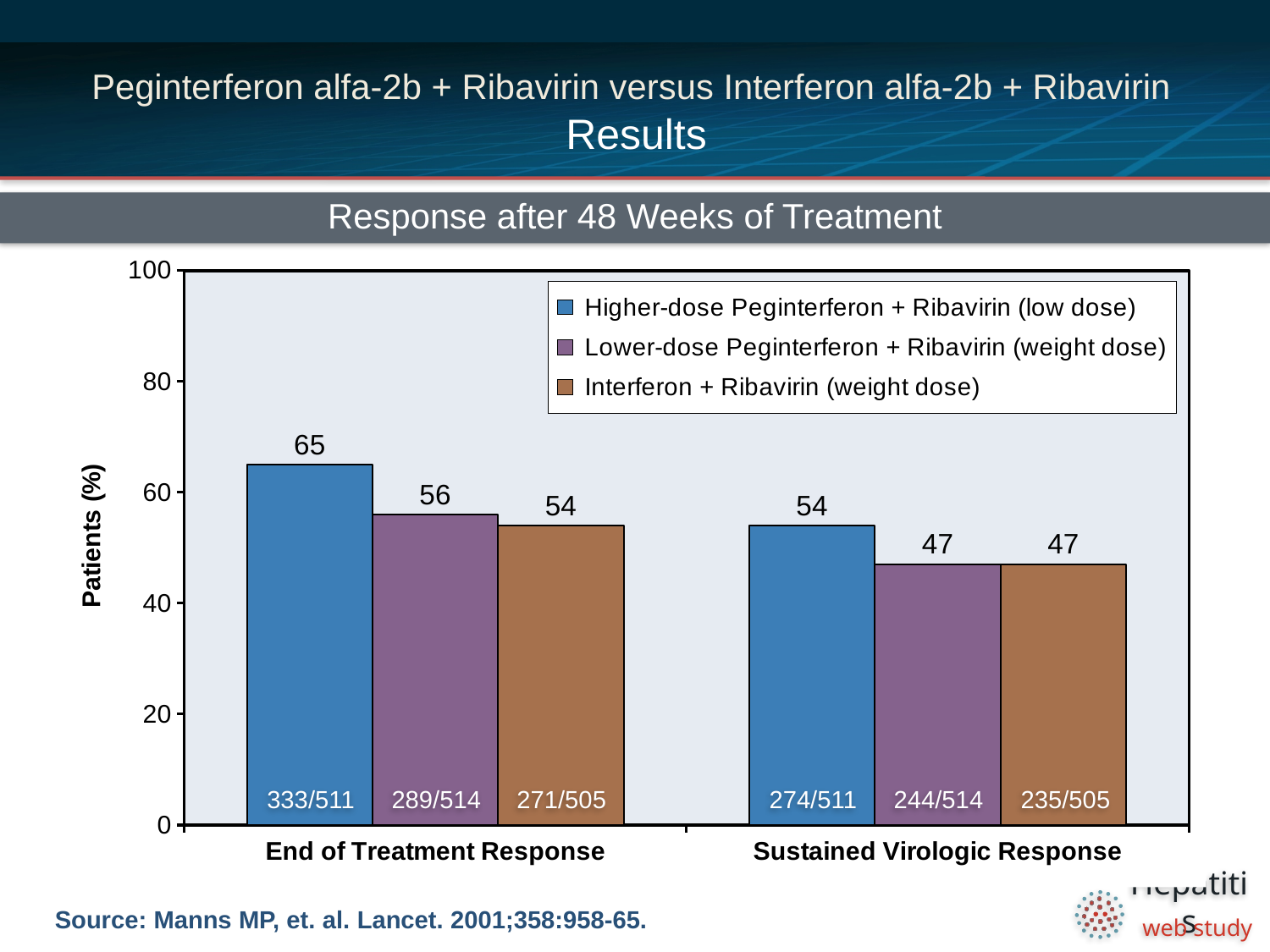
What is the Sustained Virologic Response value for Interferon + Ribavirin (weight dose)? 47 What is the difference in End of Treatment Response between Higher-dose Peginterferon + Ribavirin (low dose) and Lower-dose Peginterferon + Ribavirin (weight dose)? 9 What is the End of Treatment Response value for Higher-dose Peginterferon + Ribavirin (low dose)? 65 Which series has the highest End of Treatment Response? Higher-dose Peginterferon + Ribavirin (low dose) Which series has the lowest End of Treatment Response? Interferon + Ribavirin (weight dose) What is the difference between the End of Treatment Response and the Sustained Virologic Response for Higher-dose Peginterferon + Ribavirin (low dose)? 11 What is the Sustained Virologic Response value for Lower-dose Peginterferon + Ribavirin (weight dose)? 47 How many series does the legend list? 3 Which is larger: the End of Treatment Response for Lower-dose Peginterferon + Ribavirin (weight dose) or the Sustained Virologic Response for Higher-dose Peginterferon + Ribavirin (low dose)? End of Treatment Response for Lower-dose Peginterferon + Ribavirin (weight dose) How many categories are shown on the x axis? 2 What is the label on the y axis? Patients (%) What kind of chart is shown on the slide? Bar chart